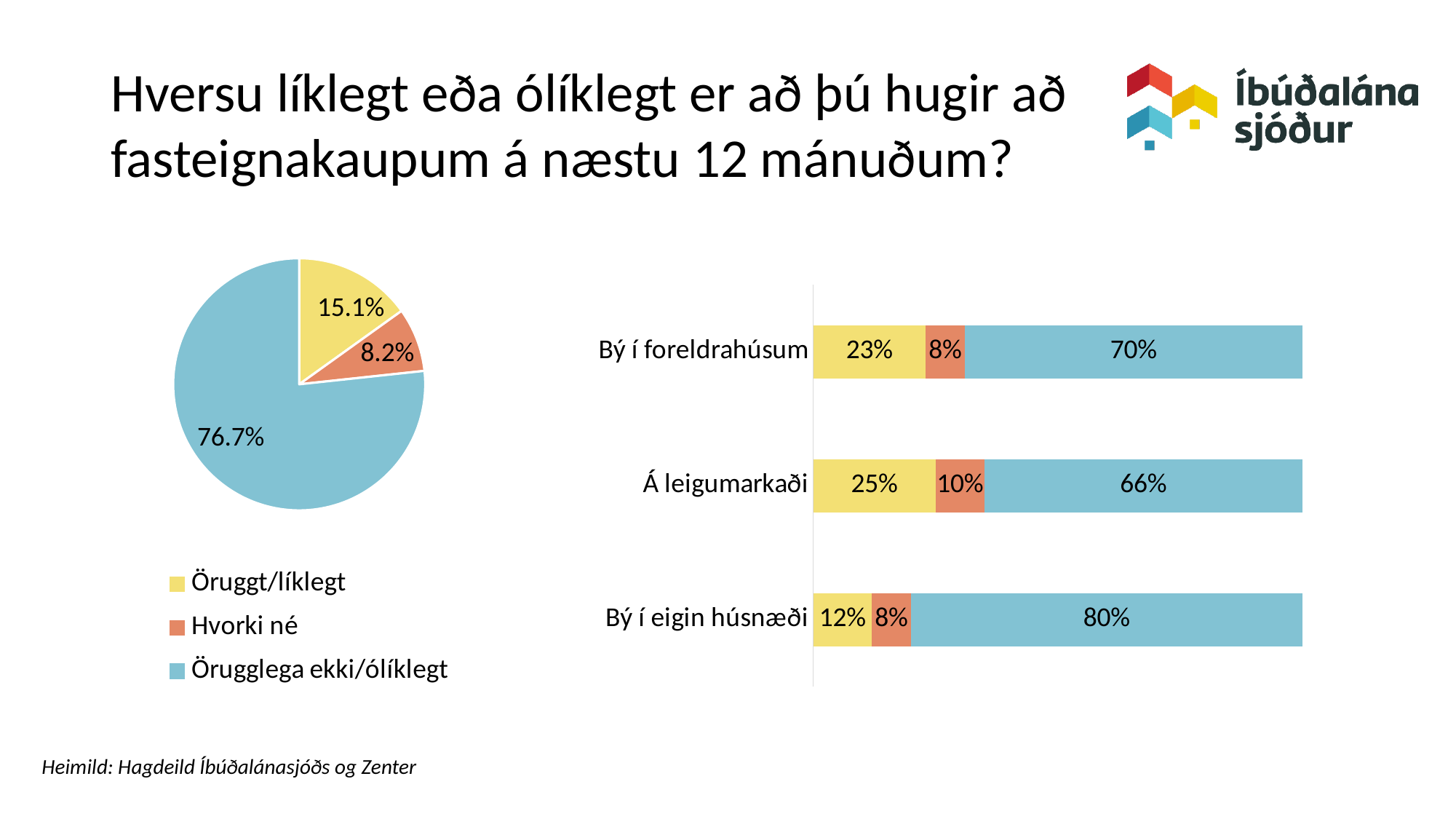
In the bar chart on the right, what is the value of the Örugglega ekki/ólíklegt segment for Á leigumarkaði? 66% In the pie chart on the left, which category has the smallest slice? Hvorki né In the pie chart on the left, how many slices are there? 3 In the pie chart on the left, which category has the largest slice? Örugglega ekki/ólíklegt In the bar chart on the right, what is the value of the Öruggt/líklegt segment for Bý í eigin húsnæði? 12% In the bar chart on the right, what is the difference between the Öruggt/líklegt values for Á leigumarkaði and Bý í foreldrahúsum? 2% What type of chart is shown on the right side of the slide? Stacked bar chart In the bar chart on the right, what is the value of the Hvorki né segment for Á leigumarkaði? 10% In the pie chart on the left, what share is labelled for Hvorki né? 8.2% In the pie chart on the left, what share is labelled for Öruggt/líklegt? 15.1% In the bar chart on the right, how many categories are shown? 3 In the bar chart on the right, which category has the highest Örugglega ekki/ólíklegt value? Bý í eigin húsnæði